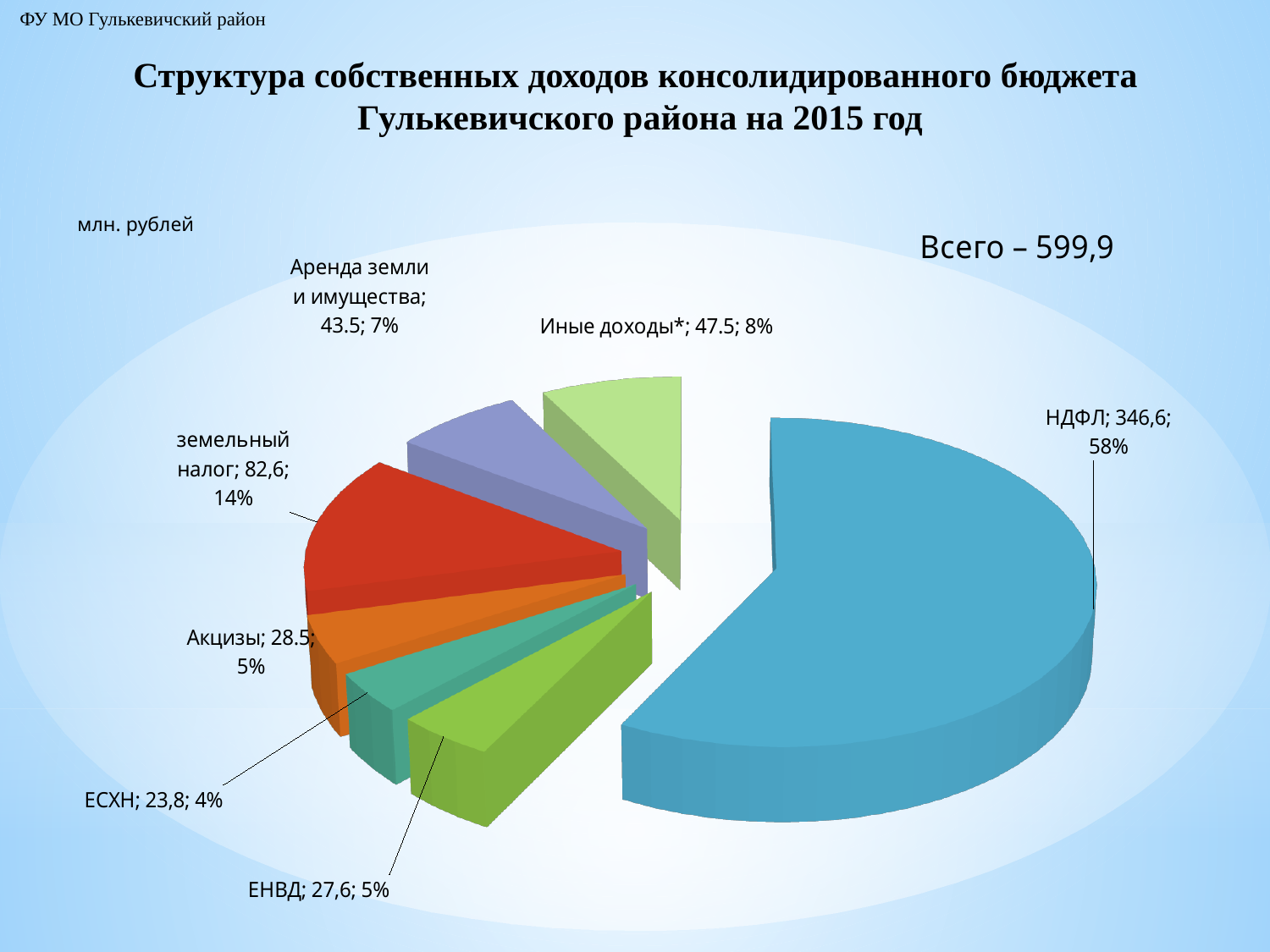
Which category has the smallest slice of the pie? ЕСХН What share of the pie does Иные доходы* account for? 8% What is the value for НДФЛ in the pie chart? 346,6 What kind of chart is shown on the slide? pie chart Which is larger, the value for Акцизы or the value for ЕСХН? Акцизы What total is stated on the slide for the pie chart (Всего)? 599,9 What is the value for земельный налог? 82,6 Which category has the largest slice of the pie? НДФЛ What share of the pie does НДФЛ account for? 58% In what units are the values in the pie chart given? млн. рублей What is the difference between the value for Иные доходы* and the value for Аренда земли и имущества? 4 How many slices does the pie chart have? 7